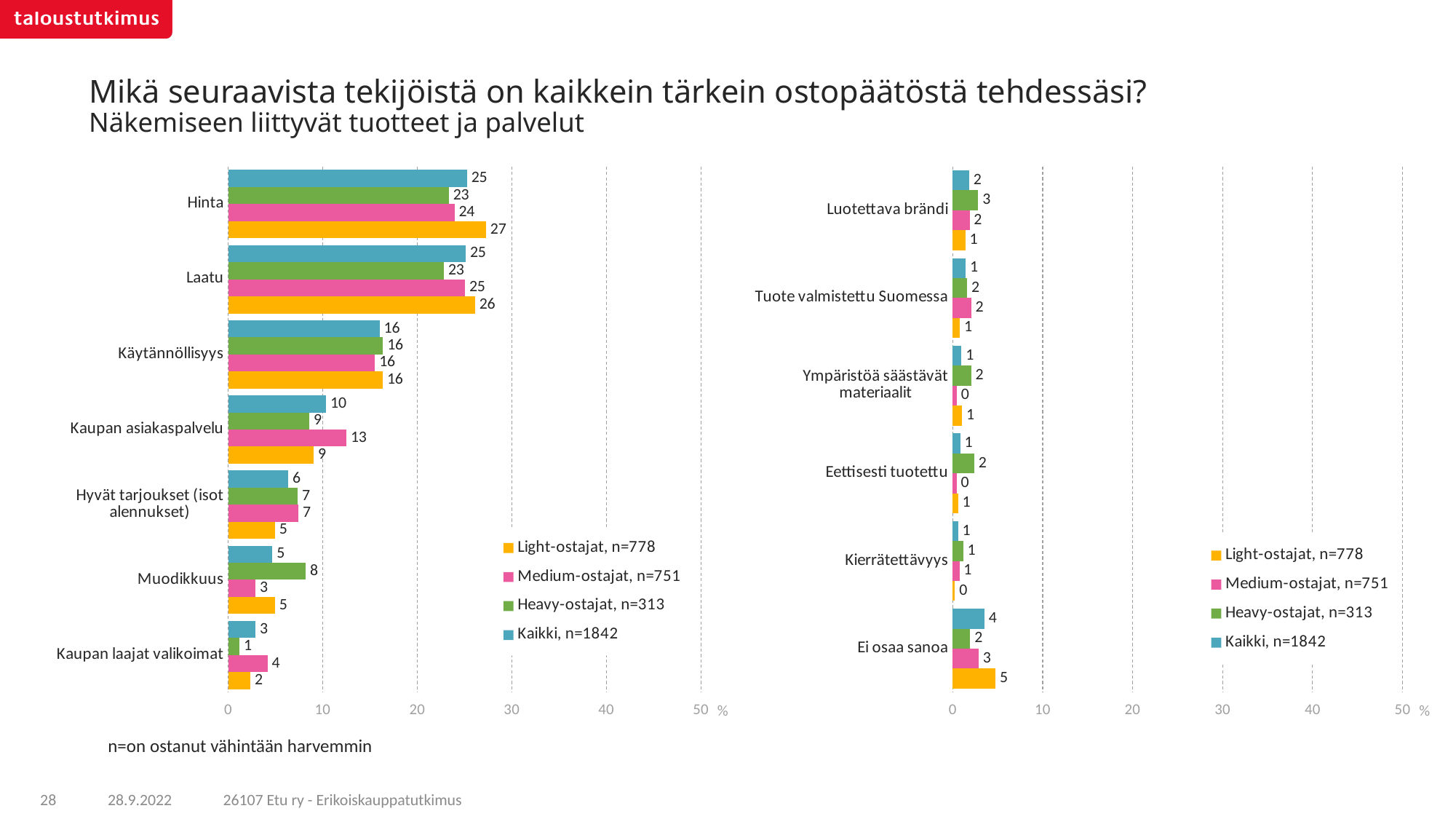
In the left chart, what is the value for Kaupan asiakaspalvelu for Medium-ostajat, n=751? 13 In the right chart, what is the value for Ei osaa sanoa for Light-ostajat, n=778? 5 In the left chart, what is the value for Hinta for Light-ostajat, n=778? 27 In the left chart, which category has the highest value for Kaikki, n=1842? Hinta and Laatu (both 25) In the left chart, which is larger for Muodikkuus: the Heavy-ostajat value or the Medium-ostajat value? Heavy-ostajat In the left chart, what is the value for Muodikkuus for Heavy-ostajat, n=313? 8 What type of chart is the left chart? Bar chart How many categories does the right chart show? 6 In the right chart, what is the value for Luotettava brändi for Heavy-ostajat, n=313? 3 In the left chart, which category has the lowest value for Light-ostajat, n=778? Kaupan laajat valikoimat In the left chart, what is the difference between the Light-ostajat and Heavy-ostajat values for Hinta? 4 How many series does the legend of the left chart list? 4